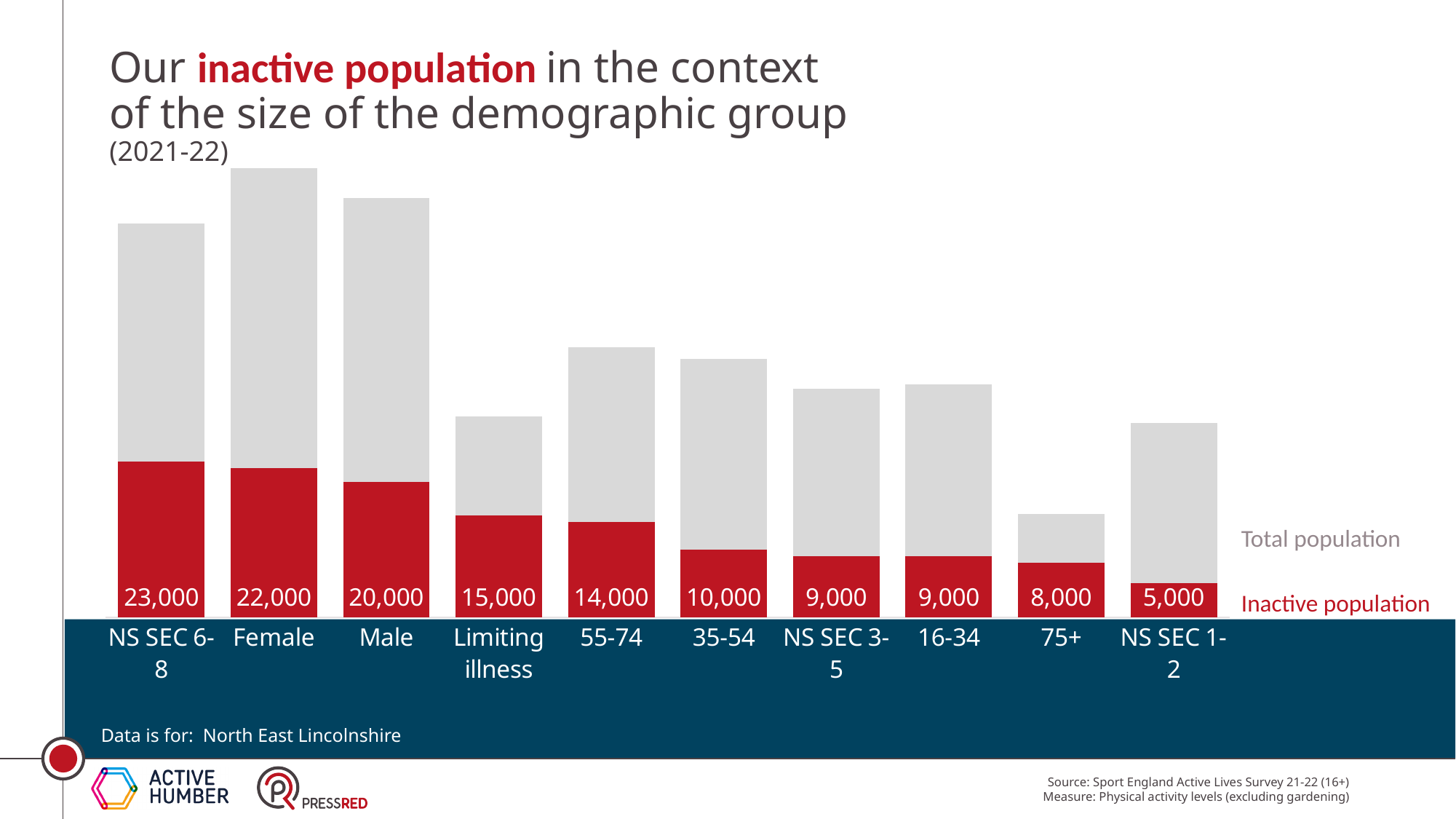
Which has a larger inactive population, 35-54 or 75+? 35-54 What is the inactive population for Female? 22,000 Do the inactive population values rise or fall from left to right across the chart? fall What is the inactive population for NS SEC 1-2? 5,000 Which demographic group has the largest total population? Female What is the difference between the inactive population of Male and Limiting illness? 5,000 Which demographic group has the smallest total population? 75+ How many series does the chart show? 2 What is the inactive population for the 55-74 age group? 14,000 Which demographic group has the highest inactive population? NS SEC 6-8 Which demographic group has the lowest inactive population? NS SEC 1-2 How many demographic groups are shown on the chart? 10